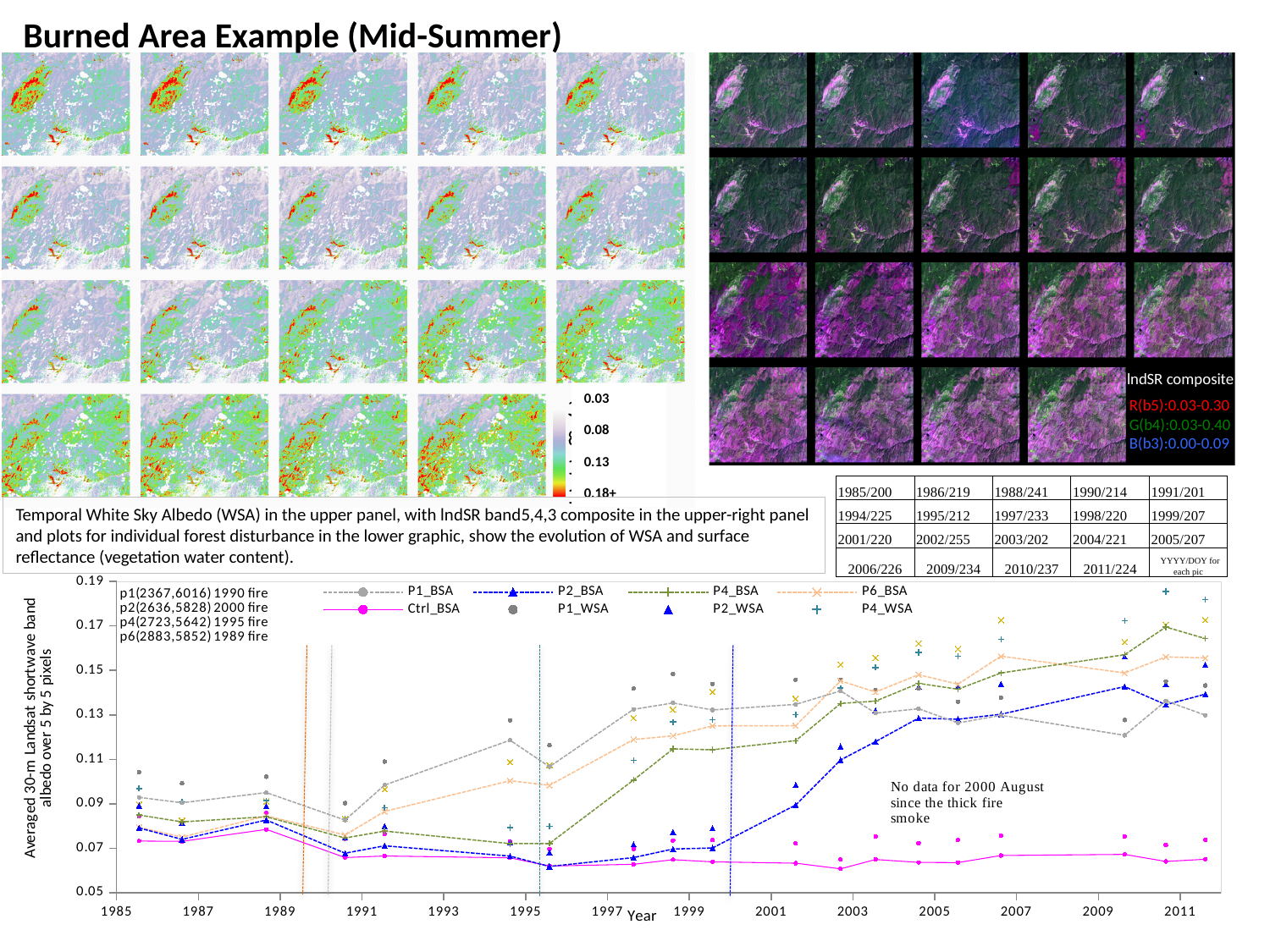
How many series does the legend of the bottom chart list? 8 In the bottom chart, which series has the lowest values across the whole period? Ctrl_BSA In the bottom chart, does the P2_BSA series rise or fall between 2000 and 2011? rise In the bottom chart, which is larger in 1995: P1_BSA or P2_BSA? P1_BSA According to the note on the bottom chart, for which year and month is there no data? 2000 August In the bottom chart, is the P2_BSA value in 1995 greater or less than 0.07? less What is the label of the x axis of the bottom chart? Year What kind of chart is shown at the bottom of the slide? line chart In the bottom chart, which is larger in 2011: P4_BSA or Ctrl_BSA? P4_BSA In the bottom chart, which BSA series has the highest value in 2011? P4_BSA In the bottom chart, is the P4_BSA value in 2010 greater or less than 0.15? greater In the bottom chart, is the Ctrl_BSA value in 2011 greater or less than 0.09? less